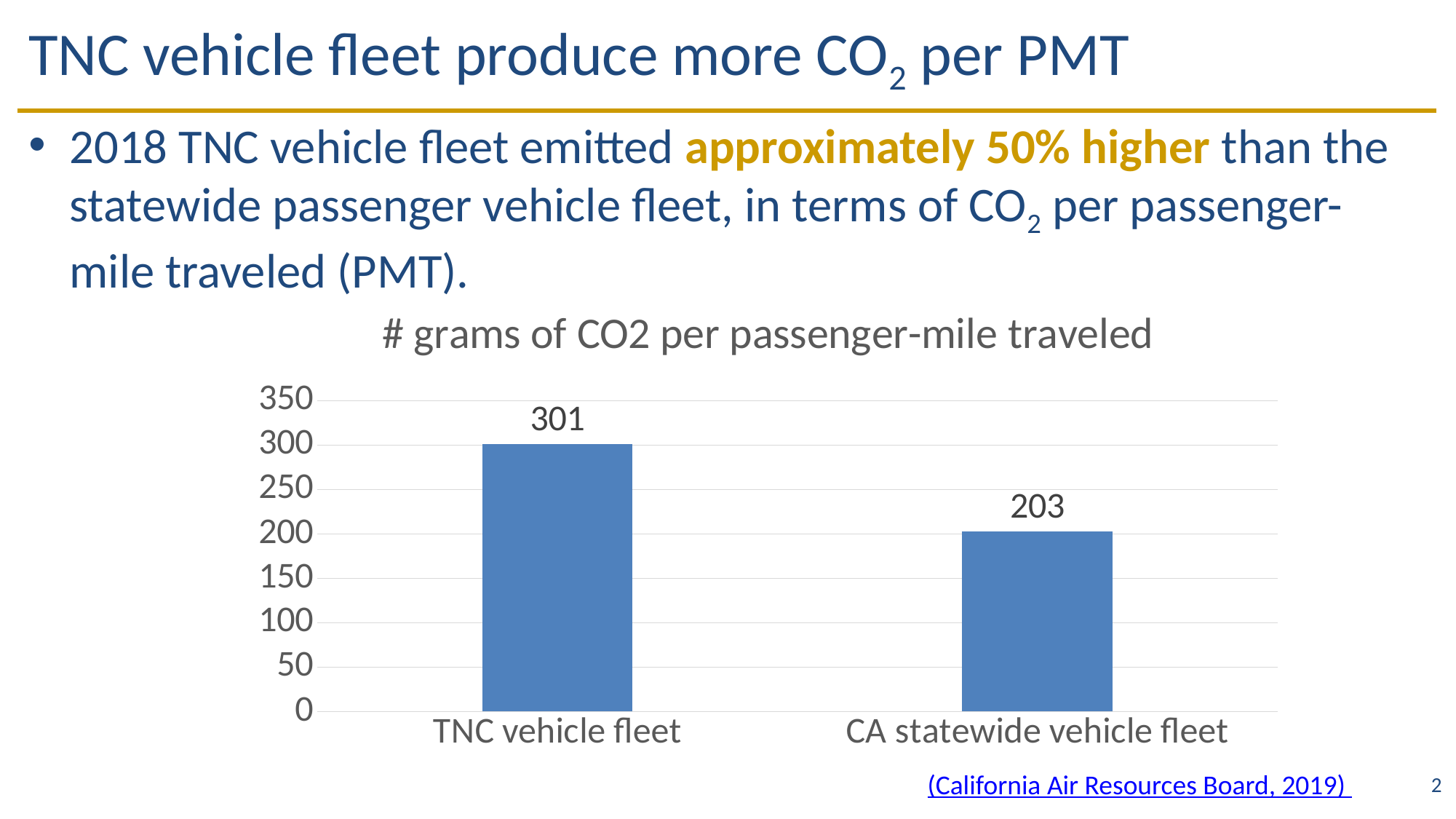
What is the highest value shown on the vertical axis of the chart? 350 Is the value for TNC vehicle fleet greater or less than 250? greater Is the value for CA statewide vehicle fleet greater or less than 250? less What kind of chart is shown on the slide? bar chart Which is larger, the value for TNC vehicle fleet or the value for CA statewide vehicle fleet? TNC vehicle fleet How many categories are shown in the chart? 2 What is the value for CA statewide vehicle fleet? 203 Which category has the lowest value? CA statewide vehicle fleet Which category has the highest value? TNC vehicle fleet What is the title of the chart? # grams of CO2 per passenger-mile traveled What is the value for TNC vehicle fleet? 301 What is the difference between the TNC vehicle fleet value and the CA statewide vehicle fleet value? 98